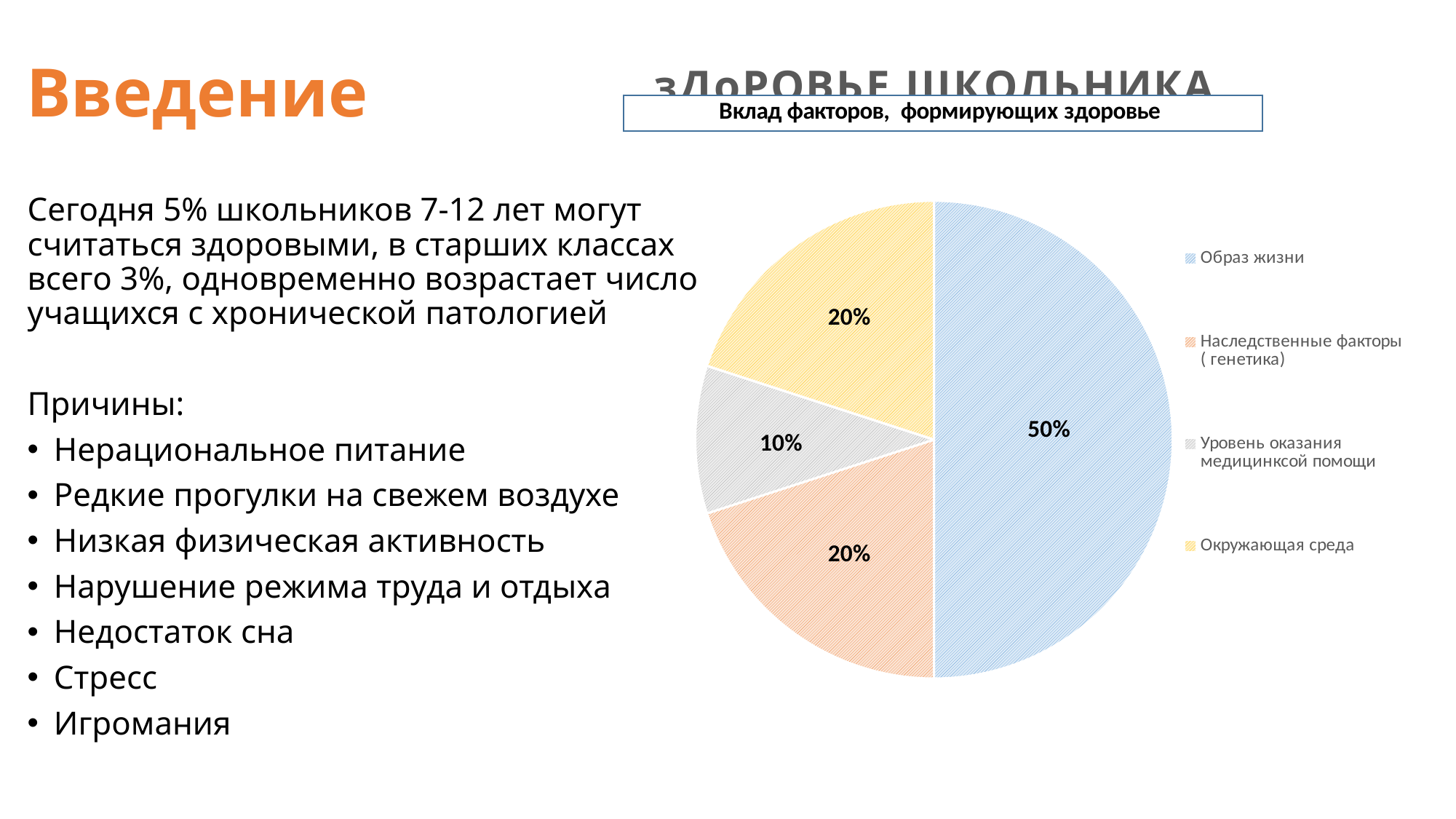
What is the difference between the share for "Образ жизни" and the share for "Окружающая среда"? 30% What share of the pie does "Уровень оказания медицинксой помощи" take? 10% What share of the pie does "Наследственные факторы (генетика)" take? 20% Which is larger: the share for "Наследственные факторы (генетика)" or the share for "Уровень оказания медицинксой помощи"? Наследственные факторы (генетика) What share of the pie does "Образ жизни" take? 50% What kind of chart is shown on the slide? Pie chart What is the title of the chart? зДоРОВЬЕ ШКОЛЬНИКА Which legend entry is shown in yellow? Окружающая среда Which category has the smallest slice of the pie? Уровень оказания медицинксой помощи Which category has the largest slice of the pie? Образ жизни How many slices does the pie chart have? 4 What share of the pie does "Окружающая среда" take? 20%